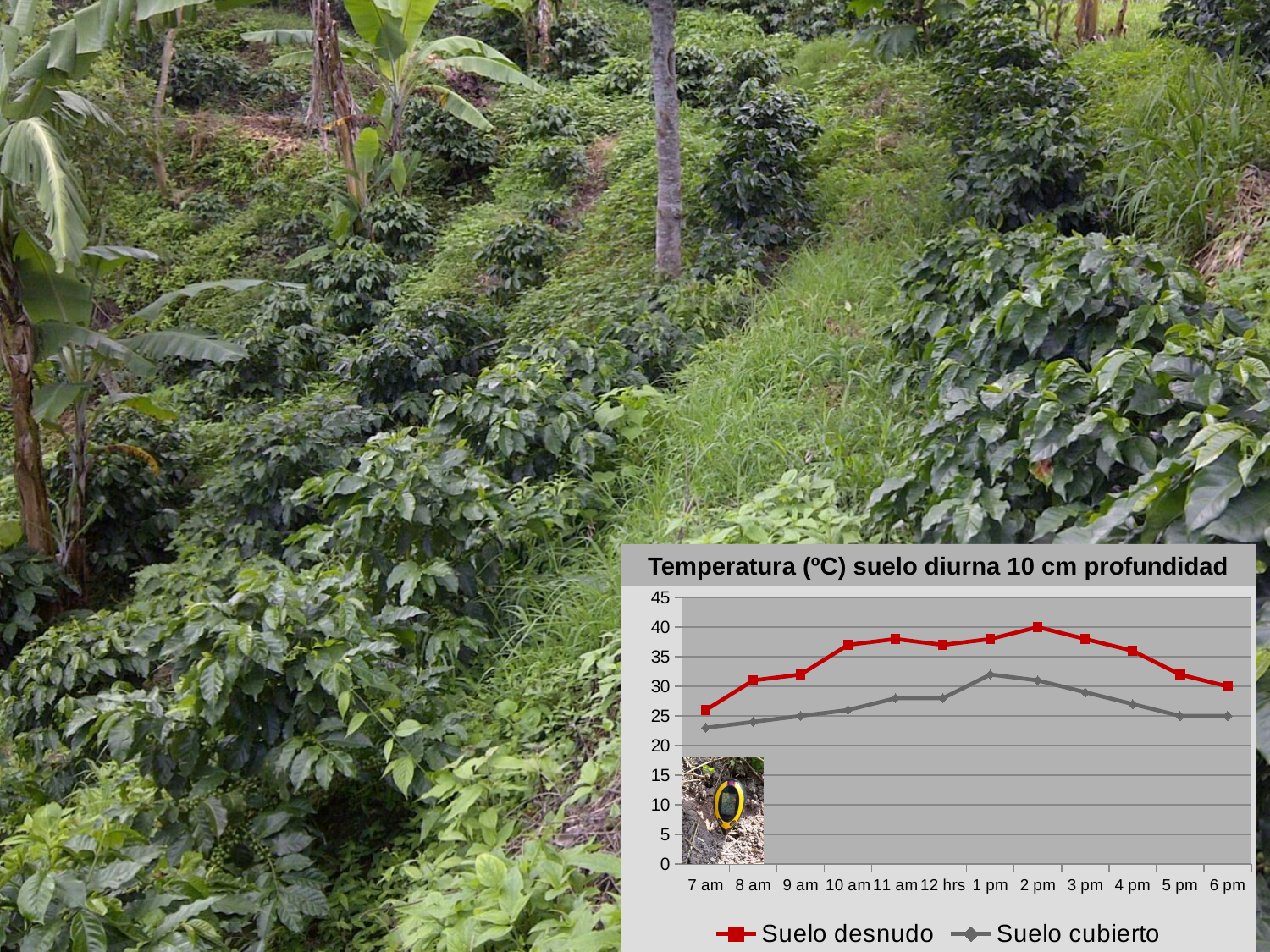
At which time does the Suelo cubierto series reach its highest value? 1 pm What is the title of the chart? Temperatura (ºC) suelo diurna 10 cm profundidad Does the Suelo desnudo series rise or fall from 2 pm to 6 pm? fall How many series does the legend list? 2 Is the value for Suelo cubierto at 1 pm greater or less than 35? less How many time points are plotted along the x axis? 12 What kind of chart is shown on the slide? line chart At which time is the Suelo cubierto series at its lowest value? 7 am At which time is the Suelo desnudo series at its lowest value? 7 am At which time does the Suelo desnudo series reach its highest value? 2 pm Is the value for Suelo desnudo at 10 am greater or less than 35? greater At 10 am, which series has the higher value, Suelo desnudo or Suelo cubierto? Suelo desnudo